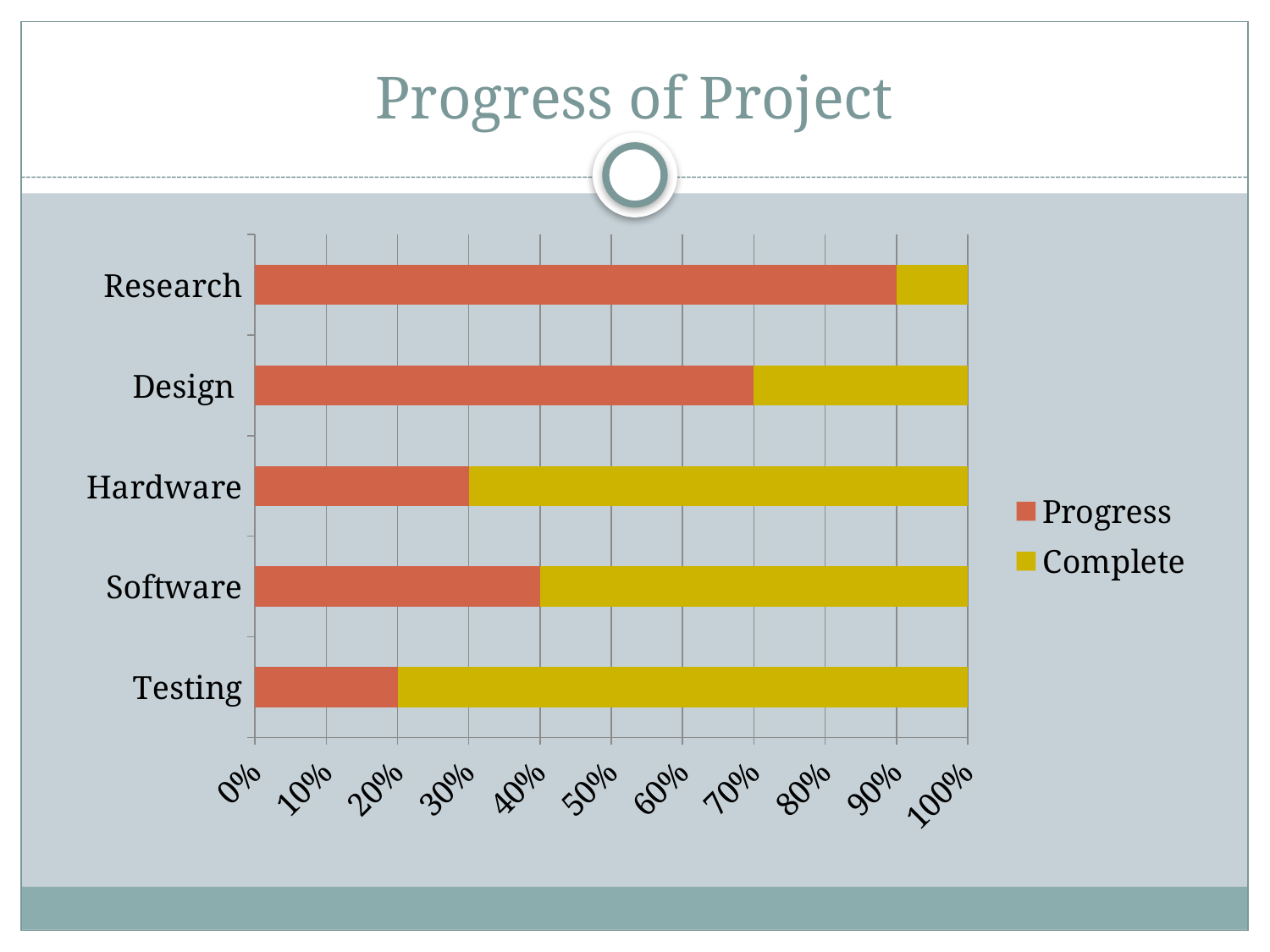
What is the Progress value for Research? 90% What is the Progress value for Testing? 20% What is the Progress value for Software? 40% What kind of chart is shown on the slide? bar chart How many series does the legend list? 2 Which has a larger Progress value, Design or Hardware? Design How many categories are shown on the chart? 5 Which category has the lowest Progress value? Testing What are the two entries listed in the legend? Progress, Complete Is the Progress value for Hardware greater or less than 50%? less What is the difference between the Progress values for Research and Design? 20% Which category has the highest Progress value? Research